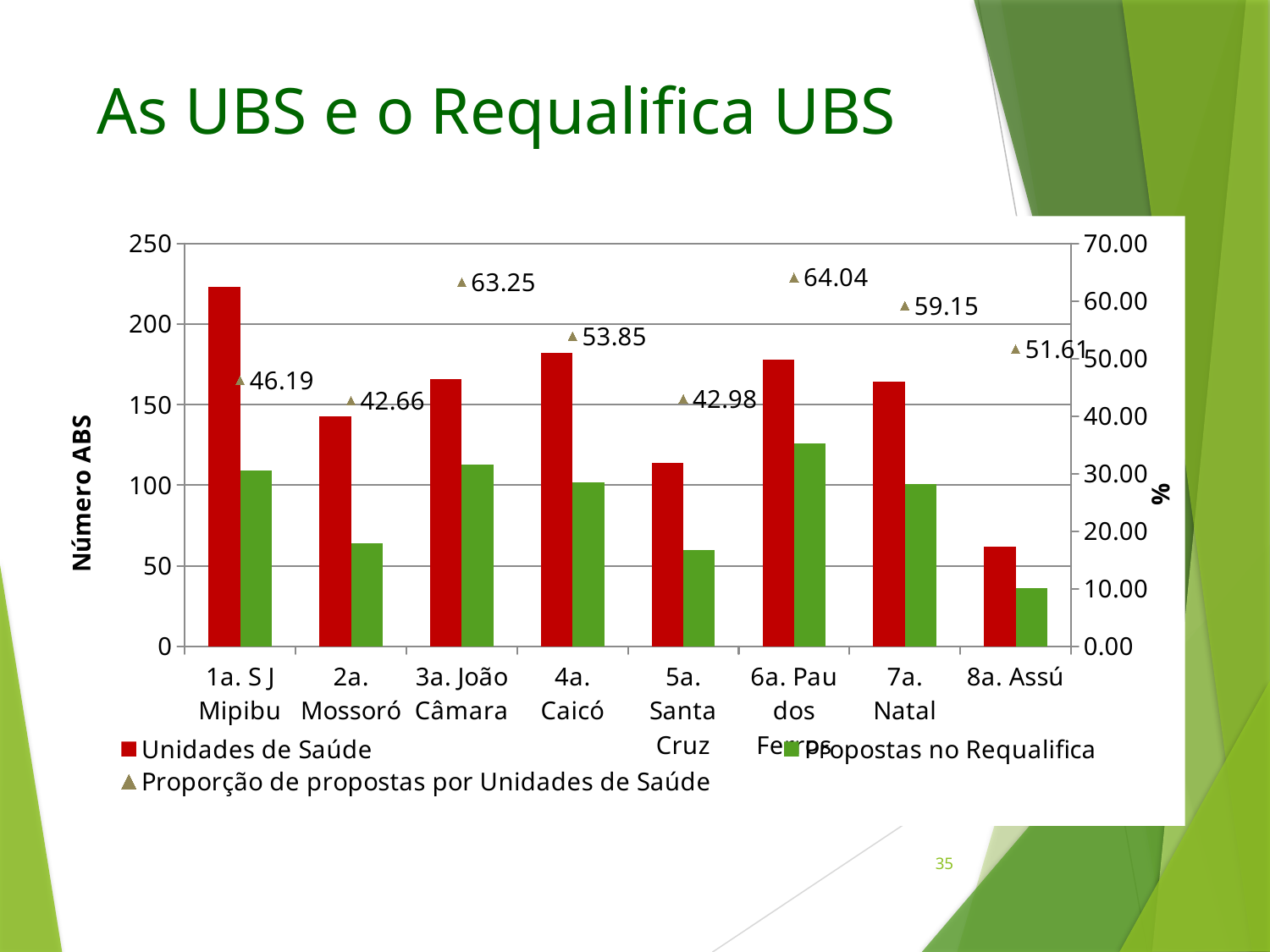
Which category has the highest 'Proporção de propostas por Unidades de Saúde'? 6a. Pau dos Ferros Which category has the shortest 'Propostas no Requalifica' bar? 8a. Assú What is the value of 'Proporção de propostas por Unidades de Saúde' for 8a. Assú? 51.61 Which category has the lowest 'Proporção de propostas por Unidades de Saúde'? 2a. Mossoró Is the 'Unidades de Saúde' value for 1a. S J Mipibu greater or less than 200? greater How many series does the legend list? 3 Which has a higher 'Proporção de propostas por Unidades de Saúde', 3a. João Câmara or 7a. Natal? 3a. João Câmara Is the 'Propostas no Requalifica' value for 8a. Assú greater or less than 50? less What is the value of 'Proporção de propostas por Unidades de Saúde' for 6a. Pau dos Ferros? 64.04 What is the difference between the 'Proporção de propostas por Unidades de Saúde' values for 6a. Pau dos Ferros and 2a. Mossoró? 21.38 What is the value of 'Proporção de propostas por Unidades de Saúde' for 1a. S J Mipibu? 46.19 Which category has the tallest 'Unidades de Saúde' bar? 1a. S J Mipibu